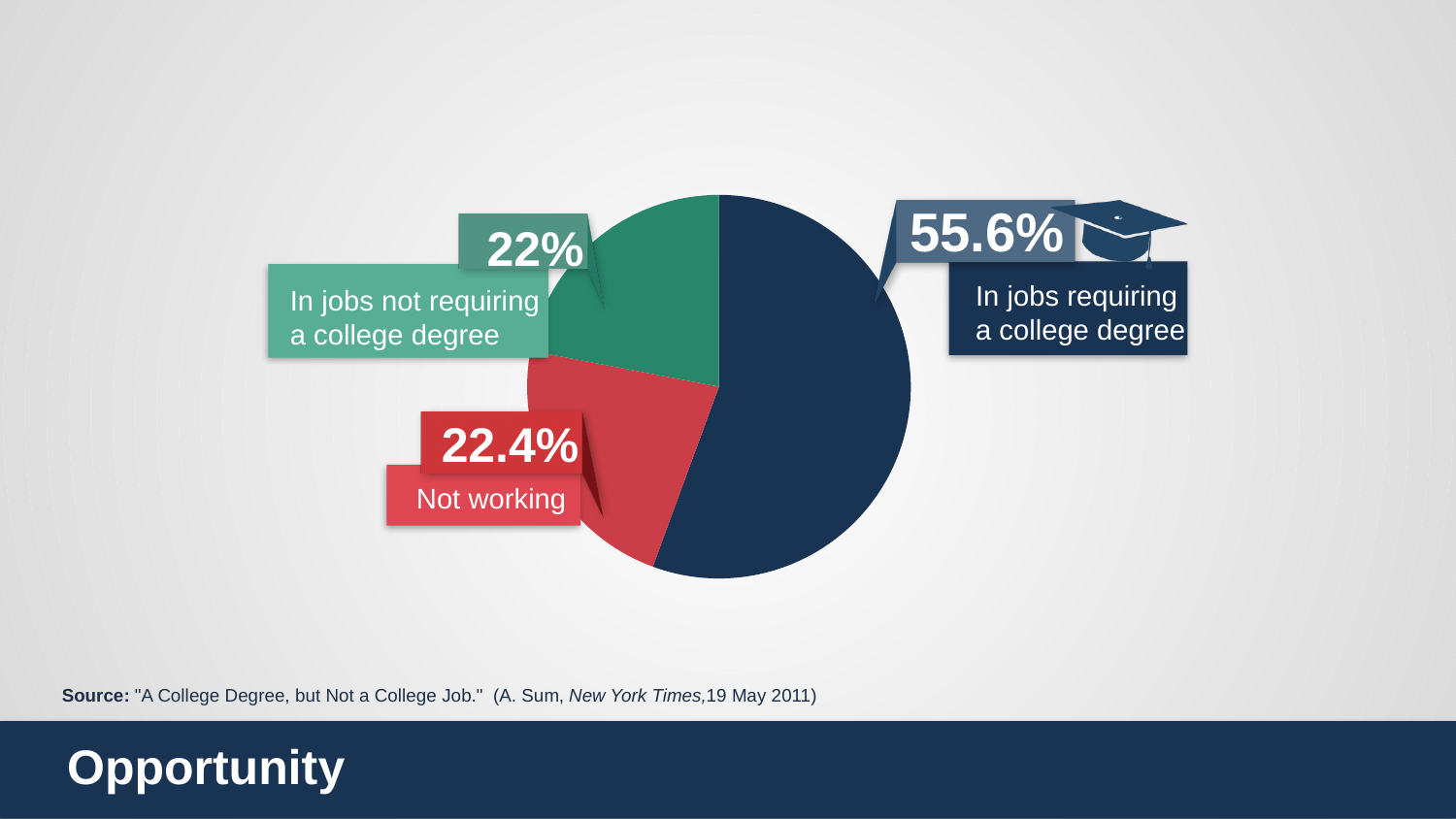
Which newspaper is cited as the source of the chart's data? New York Times Which category has the largest slice of the pie? In jobs requiring a college degree What is the difference between the "In jobs requiring a college degree" slice and the "Not working" slice? 33.2% What kind of chart is shown on the slide? Pie chart How many slices does the pie chart have? 3 What percentage of the pie is labelled "In jobs not requiring a college degree"? 22% What percentage of the pie is labelled "Not working"? 22.4% What share of the pie does the "In jobs requiring a college degree" slice represent? 55.6% What is the difference between the "In jobs requiring a college degree" slice and the "In jobs not requiring a college degree" slice? 33.6% What percentage of the pie is labelled "In jobs requiring a college degree"? 55.6% Which is larger: the "In jobs requiring a college degree" slice or the "Not working" slice? In jobs requiring a college degree What colour is the "Not working" slice of the pie? Red